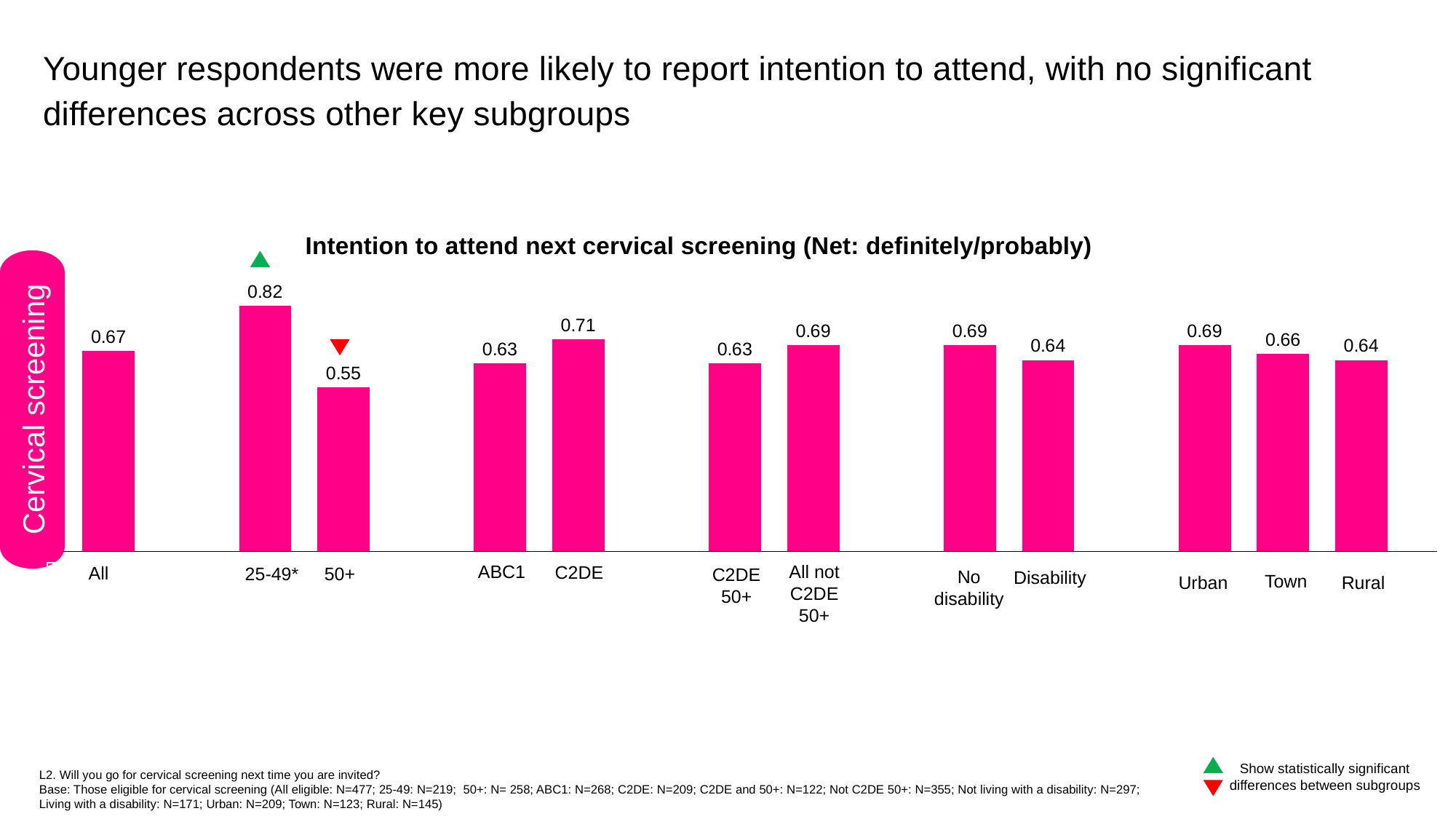
What is the value for the All group? 0.67 Which category has the highest value? 25-49* What is the difference between the values for 25-49* and 50+? 0.27 What is the value for Town? 0.66 What is the value for C2DE? 0.71 How many bars are shown in the chart? 12 What type of chart is shown on the slide? Bar chart What is the value for the 50+ group? 0.55 What is the value for the 25-49* group? 0.82 Which category has the lowest value? 50+ Which is larger, the value for ABC1 or the value for C2DE? C2DE What is the title of the chart? Intention to attend next cervical screening (Net: definitely/probably)